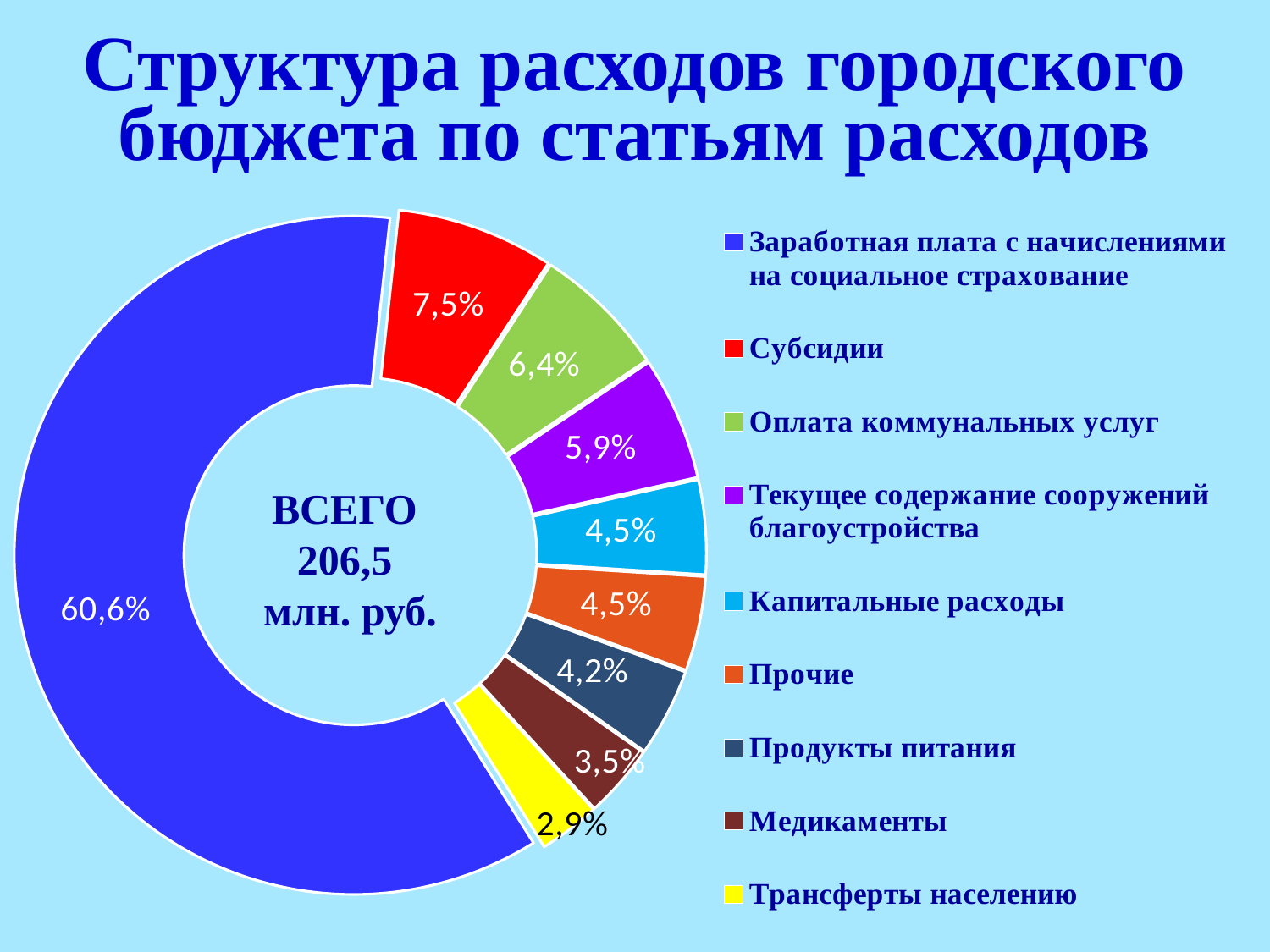
How many expenditure categories are shown in the chart? 9 Which expenditure item has the smallest share of the budget? Трансферты населению Which colour represents Капитальные расходы in the chart? Light blue What type of chart is used on the slide? Doughnut chart What share of expenditures is labelled for Оплата коммунальных услуг? 6,4% What percentage is shown for Медикаменты? 3,5% Which has a larger share: Текущее содержание сооружений благоустройства or Продукты питания? Текущее содержание сооружений благоустройства By how many percentage points does the share for Субсидии exceed the share for Оплата коммунальных услуг? 1,1 What total amount of expenditures is stated in the centre of the chart? 206,5 млн. руб. What share of the city budget expenditures goes to Субсидии? 7,5% What percentage is shown for Трансферты населению? 2,9% Which expenditure item has the largest share of the budget? Заработная плата с начислениями на социальное страхование